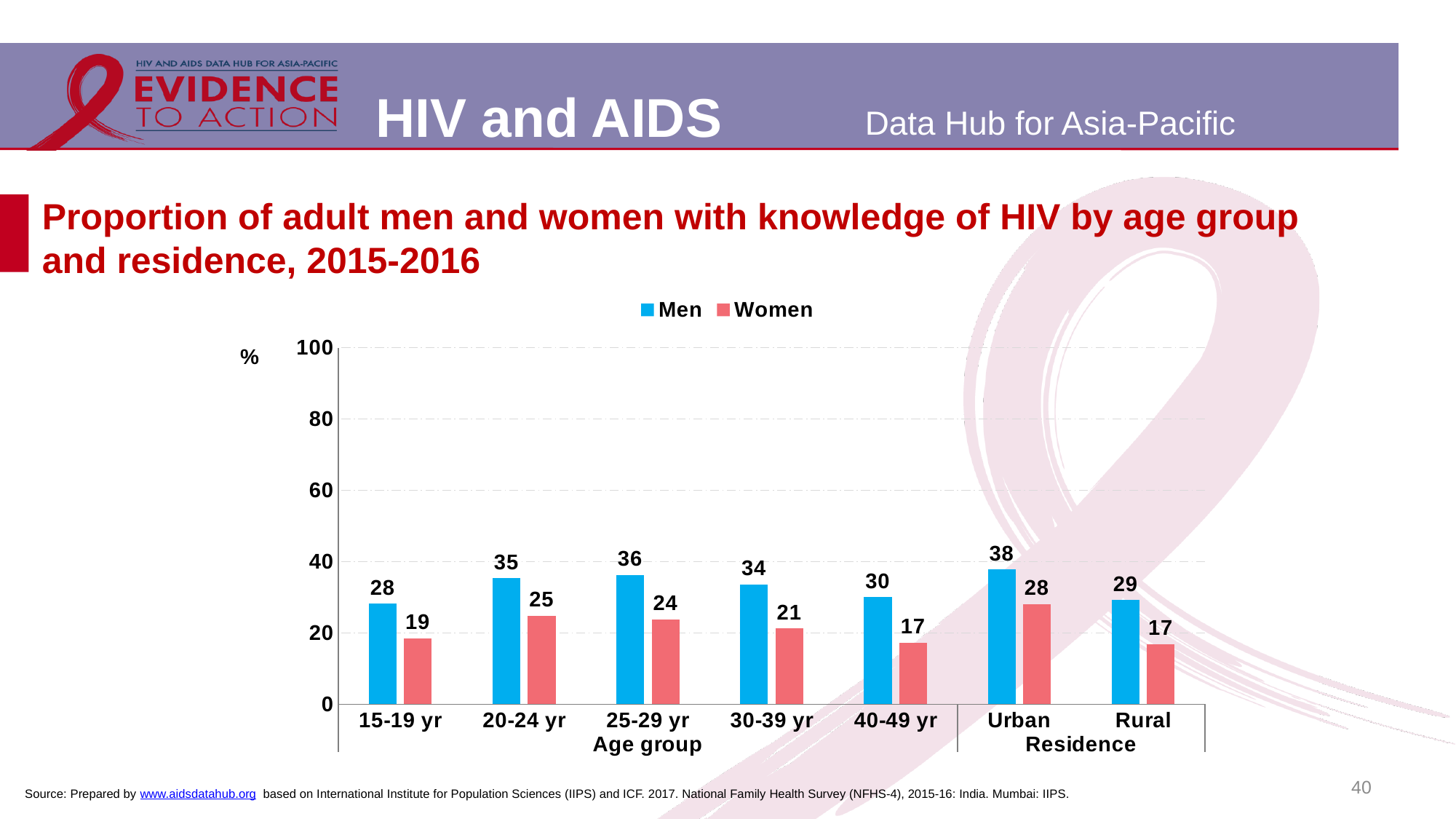
Is the value for Men in the Urban category greater or less than 40? less What is the value for Women in the 40-49 yr age group? 17 What is the value for Men in the 25-29 yr age group? 36 What colour are the bars for Women? red How many categories are shown on the x axis? 7 What is the value for Women in the Urban residence category? 28 What is the difference between Men and Women in the Rural category? 12 Which category has the highest value for Men? Urban What kind of chart is shown on the slide? bar chart How many series does the legend list? 2 Which is larger, the Men value for 20-24 yr or the Men value for 30-39 yr? 20-24 yr Which age group has the lowest value for Women? 40-49 yr